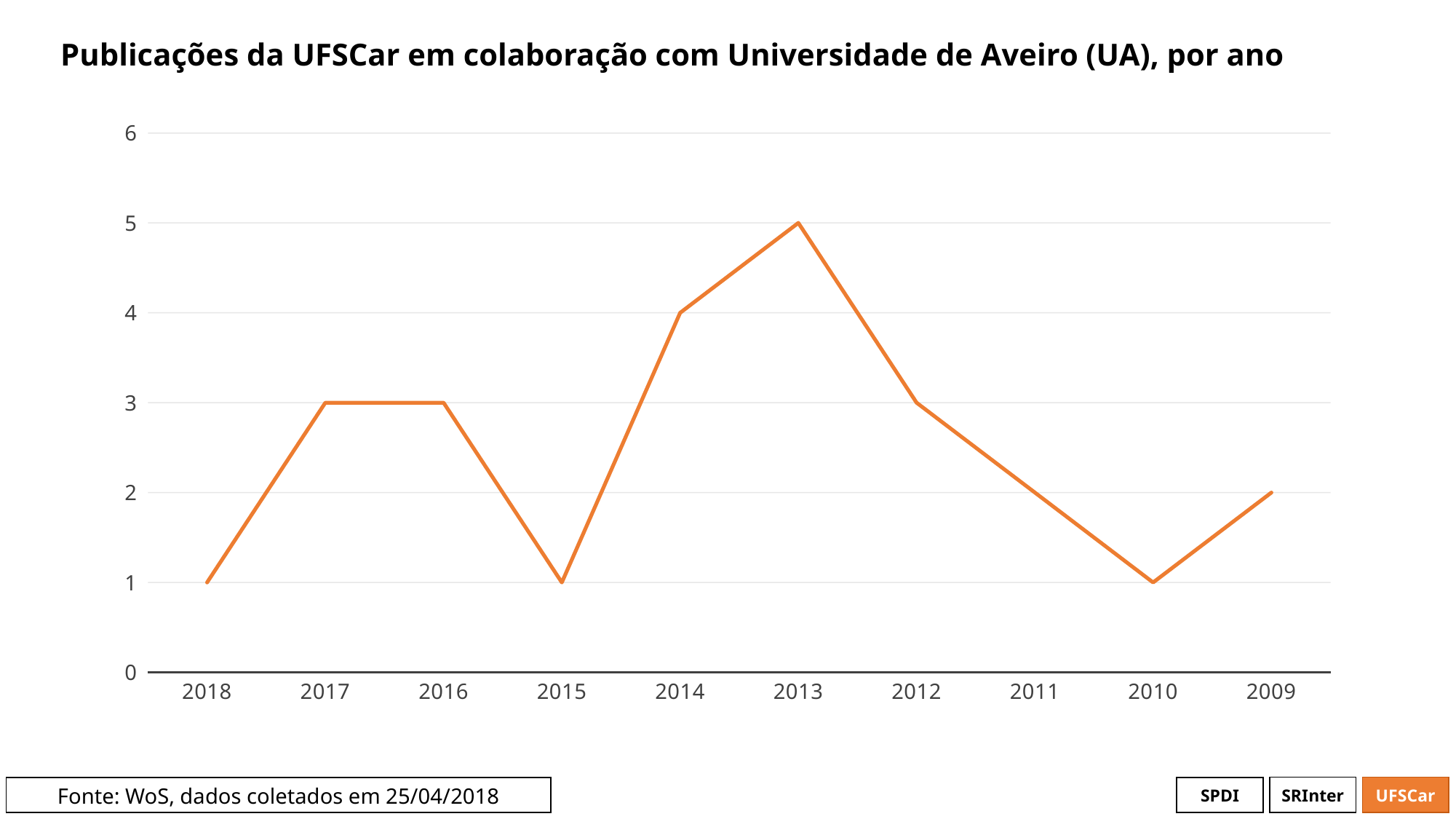
Is the value for 2011 greater or less than 3? less What is the value for 2014? 4 What is the value for 2009? 2 Which year has the highest value? 2013 What type of chart is shown on the slide? line chart What is the difference between the values for 2013 and 2014? 1 What is the value for 2013? 5 How many years are plotted on the x axis? 10 Do the values rise or fall from 2012 to 2010? fall Which year has the larger value, 2017 or 2015? 2017 What is the title of the chart? Publicações da UFSCar em colaboração com Universidade de Aveiro (UA), por ano What is the value for 2017? 3